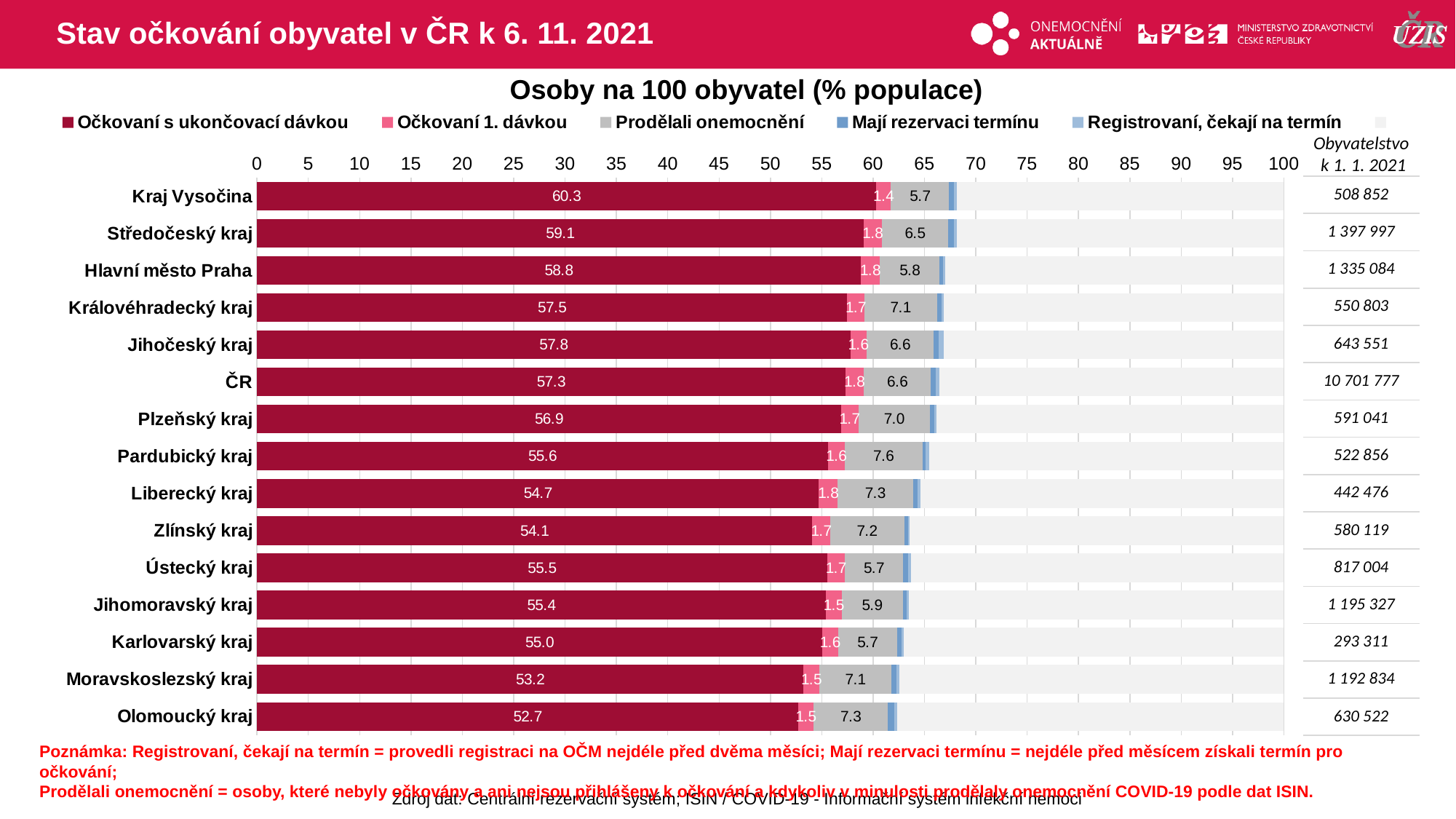
What is the title of the chart? Osoby na 100 obyvatel (% populace) What is the value of 'Očkovaní s ukončovací dávkou' for ČR? 57.3 Which region has the highest value for 'Očkovaní s ukončovací dávkou'? Kraj Vysočina What is the difference in 'Očkovaní s ukončovací dávkou' between Kraj Vysočina and Olomoucký kraj? 7.6 What is the value of 'Prodělali onemocnění' for Pardubický kraj? 7.6 Is the value of 'Očkovaní s ukončovací dávkou' for Olomoucký kraj greater or less than 55? less How many regions (rows) are plotted in the chart? 15 What is the value of 'Očkovaní s ukončovací dávkou' for Kraj Vysočina? 60.3 What is the value of 'Očkovaní 1. dávkou' for Středočeský kraj? 1.8 Which region has the lowest value for 'Očkovaní s ukončovací dávkou'? Olomoucký kraj What type of chart is shown on the slide? Bar chart Which has a larger value for 'Očkovaní s ukončovací dávkou', Liberecký kraj or Zlínský kraj? Liberecký kraj